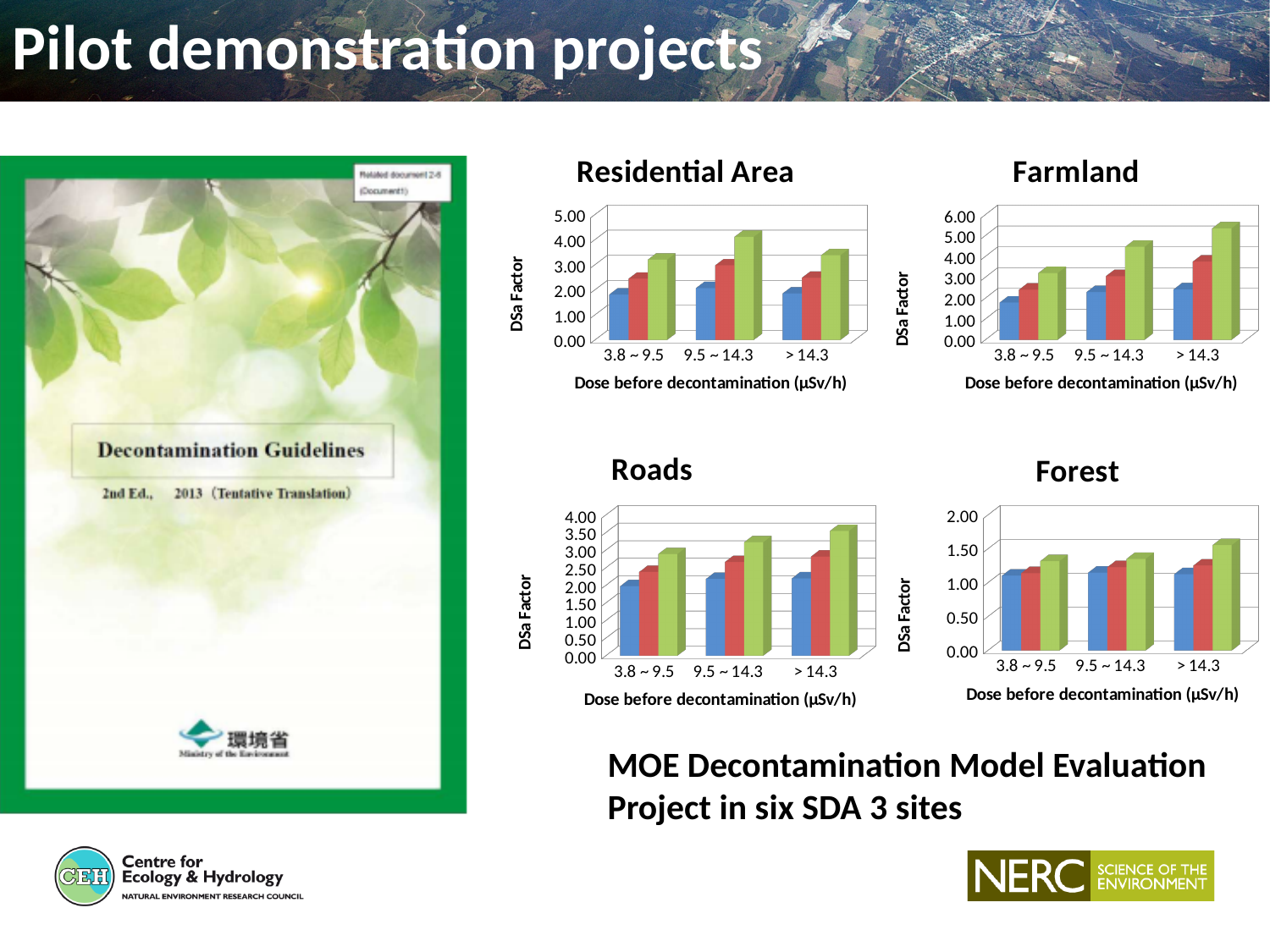
What is the x-axis title of the Forest chart? Dose before decontamination (μSv/h) In the Farmland chart, is the green bar for 9.5 ~ 14.3 greater or less than 4.00? greater In the Forest chart, which is larger for > 14.3, the blue bar or the green bar? green bar How many dose categories are shown on the x axis of the Farmland chart? 3 In the Residential Area chart, which dose category has the tallest green bar? 9.5 ~ 14.3 What kind of chart is the Residential Area chart? bar chart In the Farmland chart, which dose category has the tallest green bar? > 14.3 How many bars are plotted for each dose category in the Roads chart? 3 In the Roads chart, is the blue bar for 3.8 ~ 9.5 greater or less than 2.50? less In the Farmland chart, do the green bars rise or fall from 3.8 ~ 9.5 to > 14.3? rise What is the y-axis title of the Roads chart? DSa Factor In the Farmland chart, is the green bar for > 14.3 greater or less than 5.00? greater